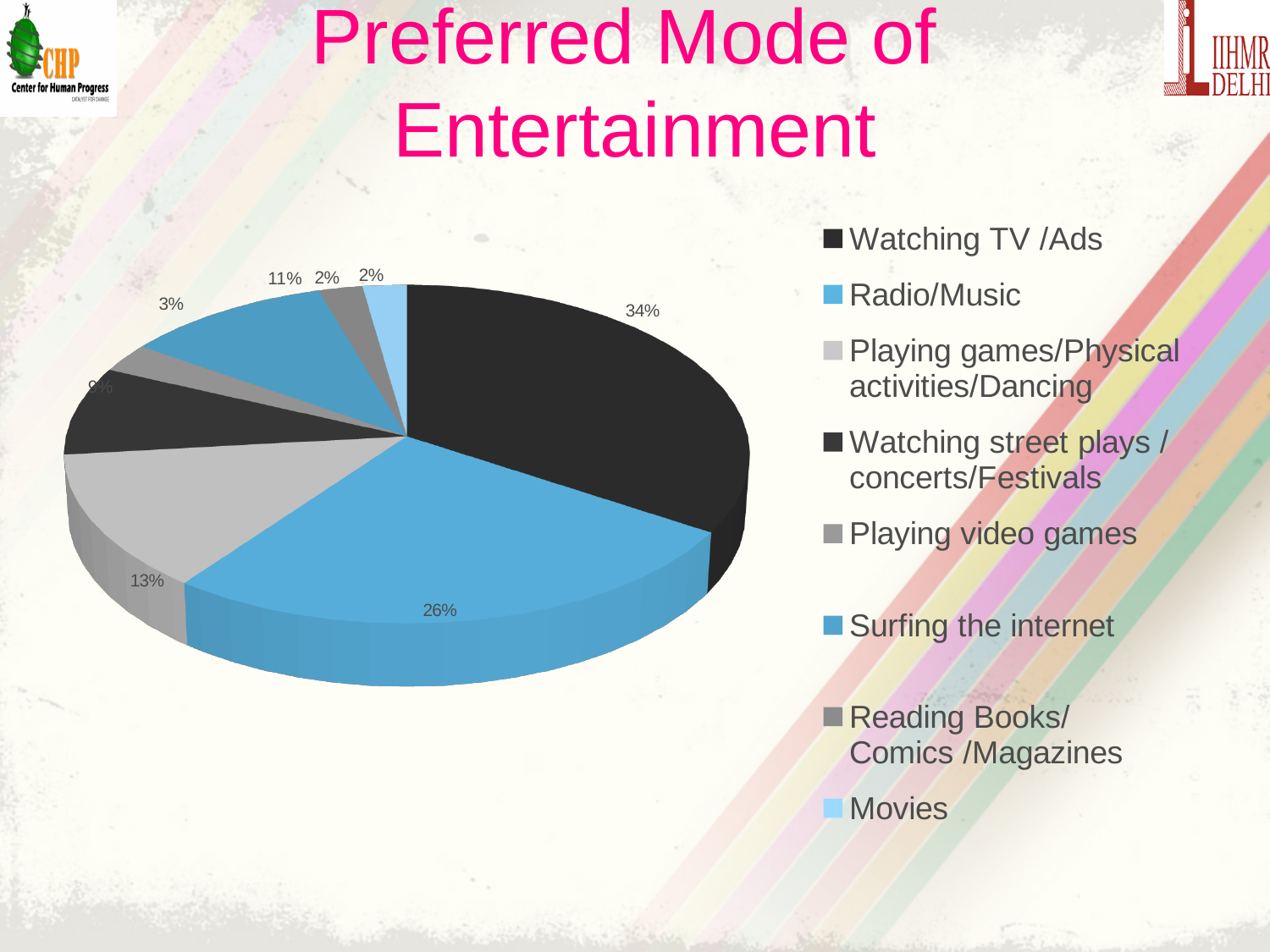
What is the difference in percentage points between Watching TV /Ads and Radio/Music? 8 What percentage of the pie is Watching TV /Ads? 34% What type of chart is shown on the slide? pie chart What percentage is shown for Surfing the internet? 11% What share does Playing games/Physical activities/Dancing have? 13% How many categories does the legend list? 8 What percentage of the pie is Radio/Music? 26% What percentage is shown for Playing video games? 3% What is the title of the chart? Preferred Mode of Entertainment Which is larger, the share for Surfing the internet or the share for Playing games/Physical activities/Dancing? Playing games/Physical activities/Dancing Which mode of entertainment has the largest share of the pie? Watching TV /Ads What percentage is shown for Movies? 2%